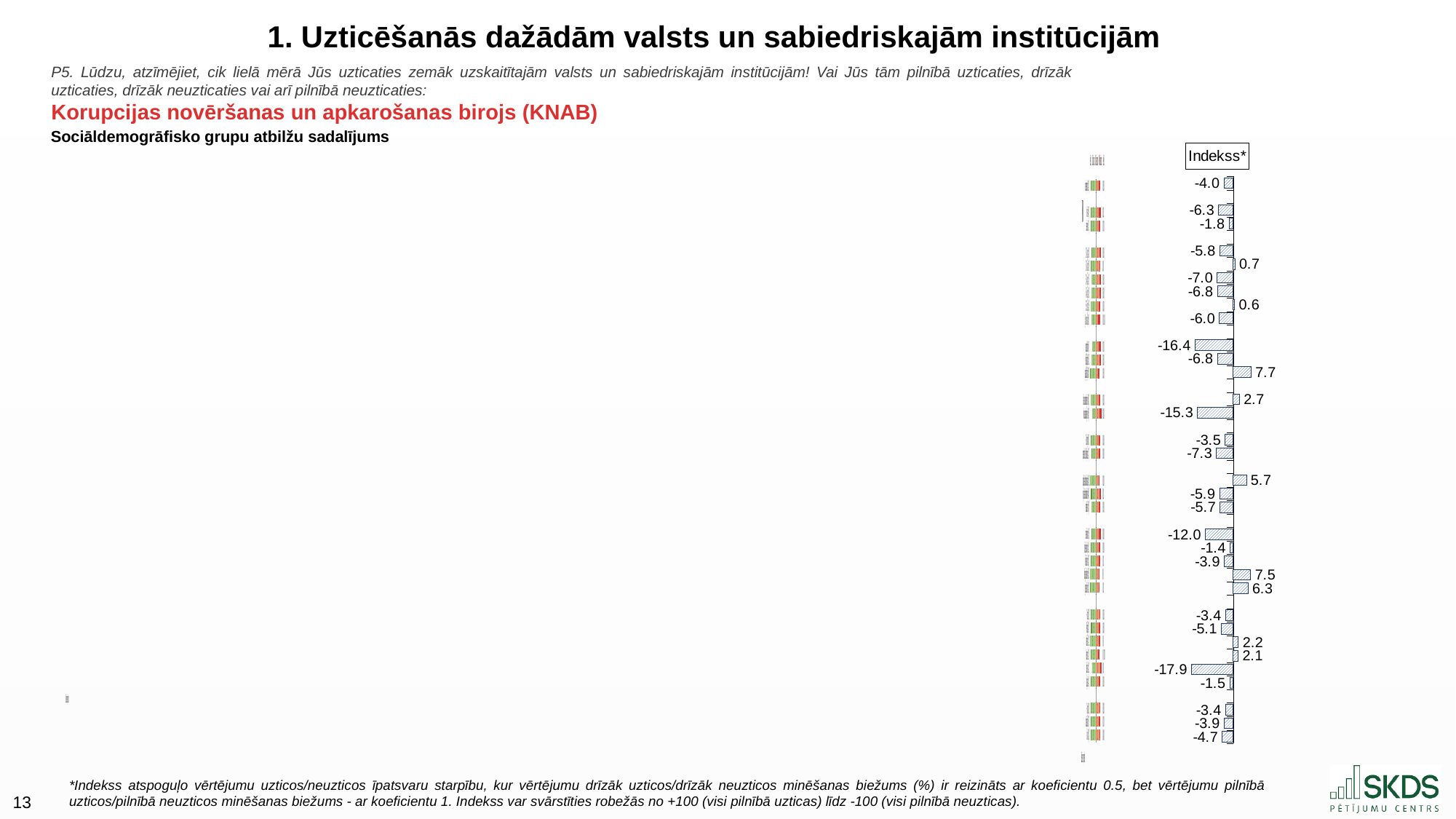
What is the topmost value shown in the Indekss* chart? -4.0 What is the smallest value shown in the Indekss* chart? -17.9 Is the lowest value in the Indekss* chart greater or less than -10? less Which institution is the slide about, as given in the red heading? Korupcijas novēršanas un apkarošanas birojs (KNAB) Is the highest value in the Indekss* chart greater or less than 10? less What is the largest value shown in the Indekss* chart? 7.7 What kind of chart is the Indekss* chart on the right of the slide? bar chart What is the title shown above the index chart on the right? Indekss* What is the bottommost value shown in the Indekss* chart? -4.7 In the Indekss* chart, which is larger: the value -16.4 or the value -15.3? -15.3 How many positive values are shown in the Indekss* chart? 9 What is the difference between the largest and smallest values in the Indekss* chart? 25.6